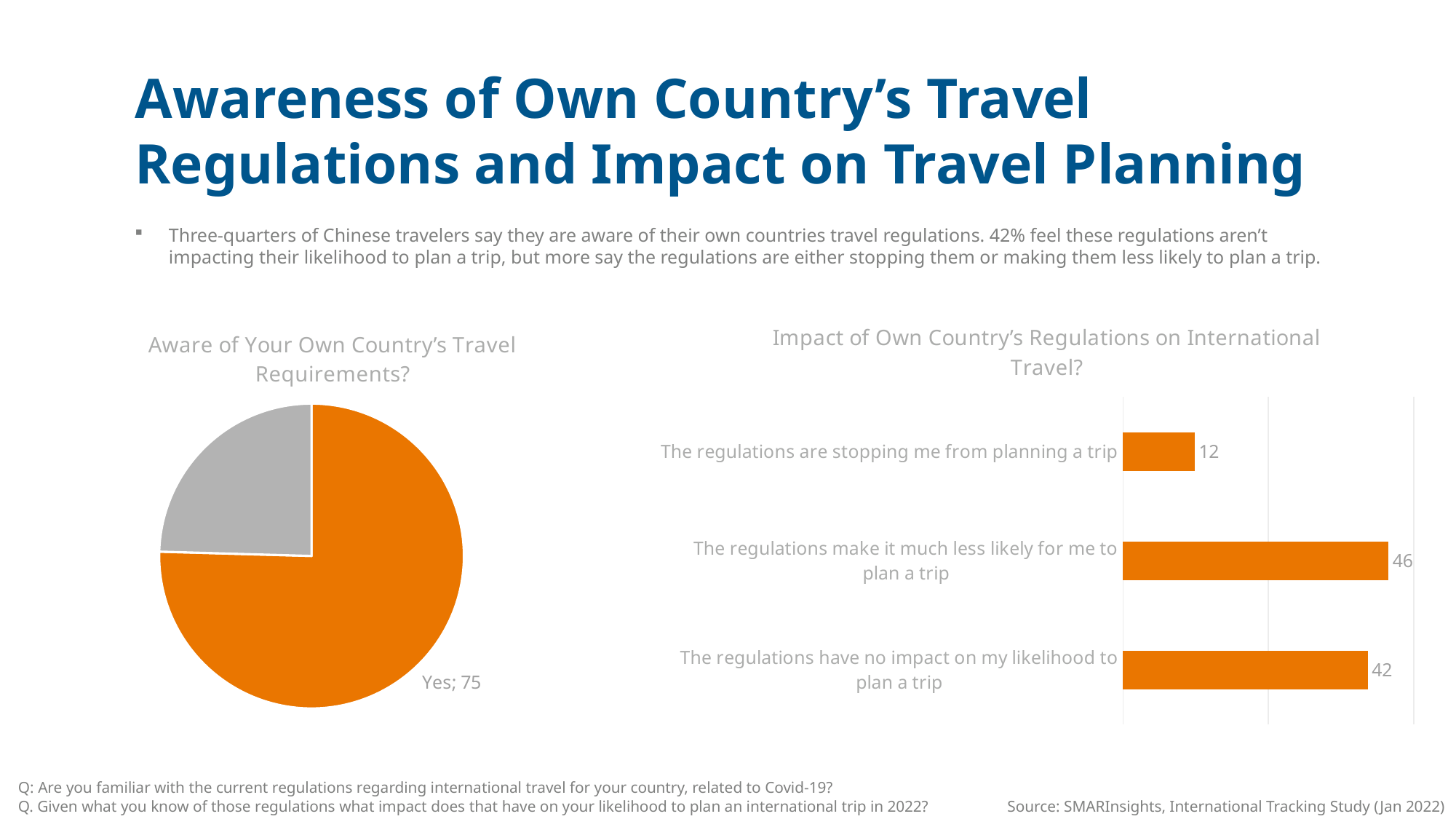
In the chart titled "Impact of Own Country's Regulations on International Travel?", which is larger: the value for "The regulations make it much less likely for me to plan a trip" or the value for "The regulations have no impact on my likelihood to plan a trip"? The regulations make it much less likely for me to plan a trip What kind of chart is the chart titled "Aware of Your Own Country's Travel Requirements?"? Pie chart How many categories are shown in the chart titled "Impact of Own Country's Regulations on International Travel?"? 3 In the chart titled "Impact of Own Country's Regulations on International Travel?", what is the value for "The regulations have no impact on my likelihood to plan a trip"? 42 In the chart titled "Impact of Own Country's Regulations on International Travel?", what is the value for "The regulations make it much less likely for me to plan a trip"? 46 In the pie chart titled "Aware of Your Own Country's Travel Requirements?", what is the value for the "Yes" slice? 75 In the pie chart titled "Aware of Your Own Country's Travel Requirements?", what colour is the "Yes" slice? Orange In the chart titled "Impact of Own Country's Regulations on International Travel?", which category has the highest value? The regulations make it much less likely for me to plan a trip In the chart titled "Impact of Own Country's Regulations on International Travel?", what is the difference between the value for "The regulations make it much less likely for me to plan a trip" and the value for "The regulations are stopping me from planning a trip"? 34 In the chart titled "Impact of Own Country's Regulations on International Travel?", which category has the lowest value? The regulations are stopping me from planning a trip What kind of chart is the chart titled "Impact of Own Country's Regulations on International Travel?"? Bar chart In the chart titled "Impact of Own Country's Regulations on International Travel?", what is the value for "The regulations are stopping me from planning a trip"? 12